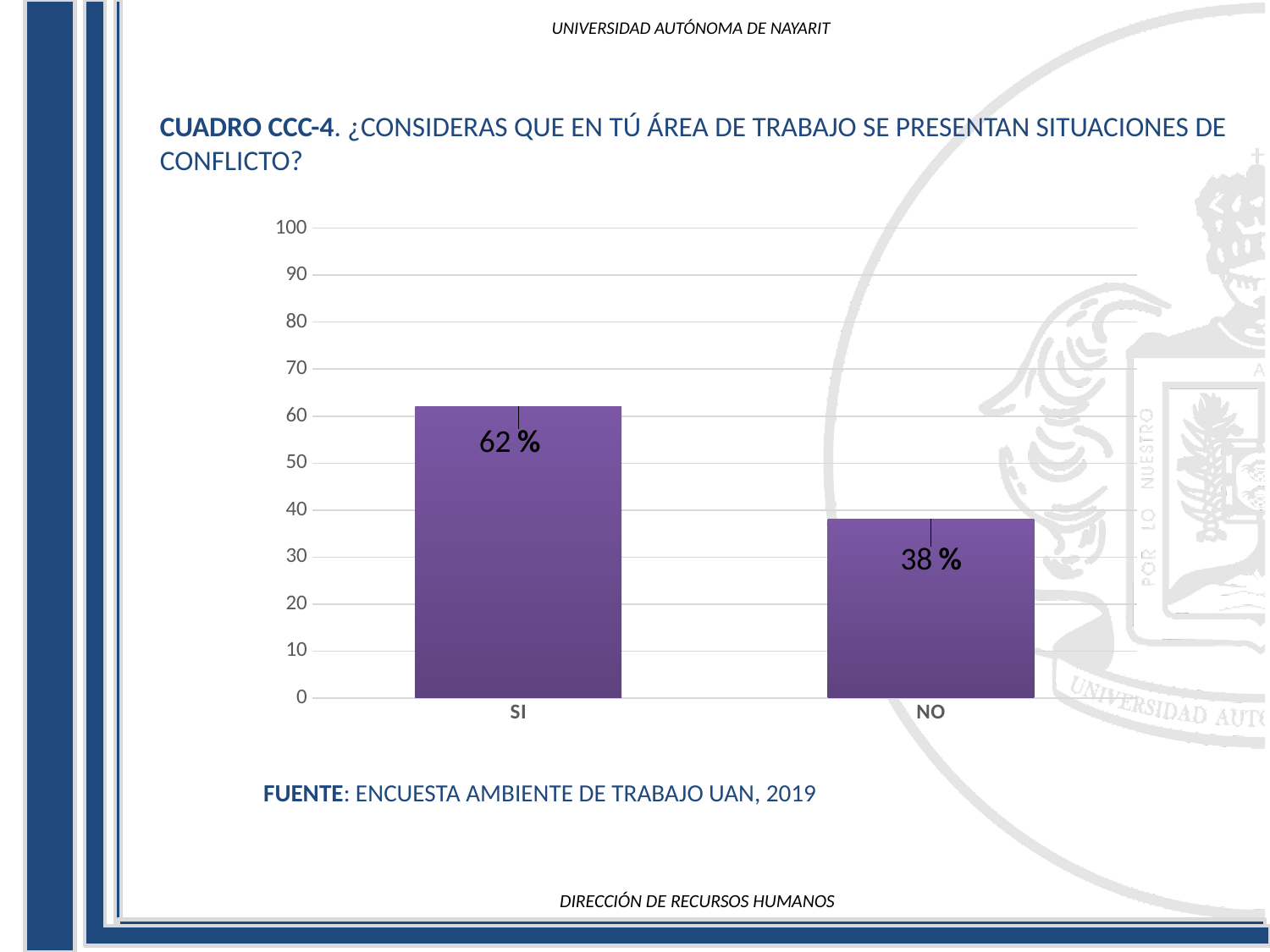
What is the difference between the values for SI and NO? 24 % What source is cited below the chart? ENCUESTA AMBIENTE DE TRABAJO UAN, 2019 How many categories are shown on the chart? 2 Which is larger, the value for SI or the value for NO? SI What kind of chart is shown on the slide? bar chart What is the highest value shown on the vertical axis? 100 Which category has the lowest value? NO Is the value for SI greater or less than 60? greater What is the value for NO? 38 % What is the value for SI? 62 % Is the value for NO greater or less than 40? less Which category has the highest value? SI